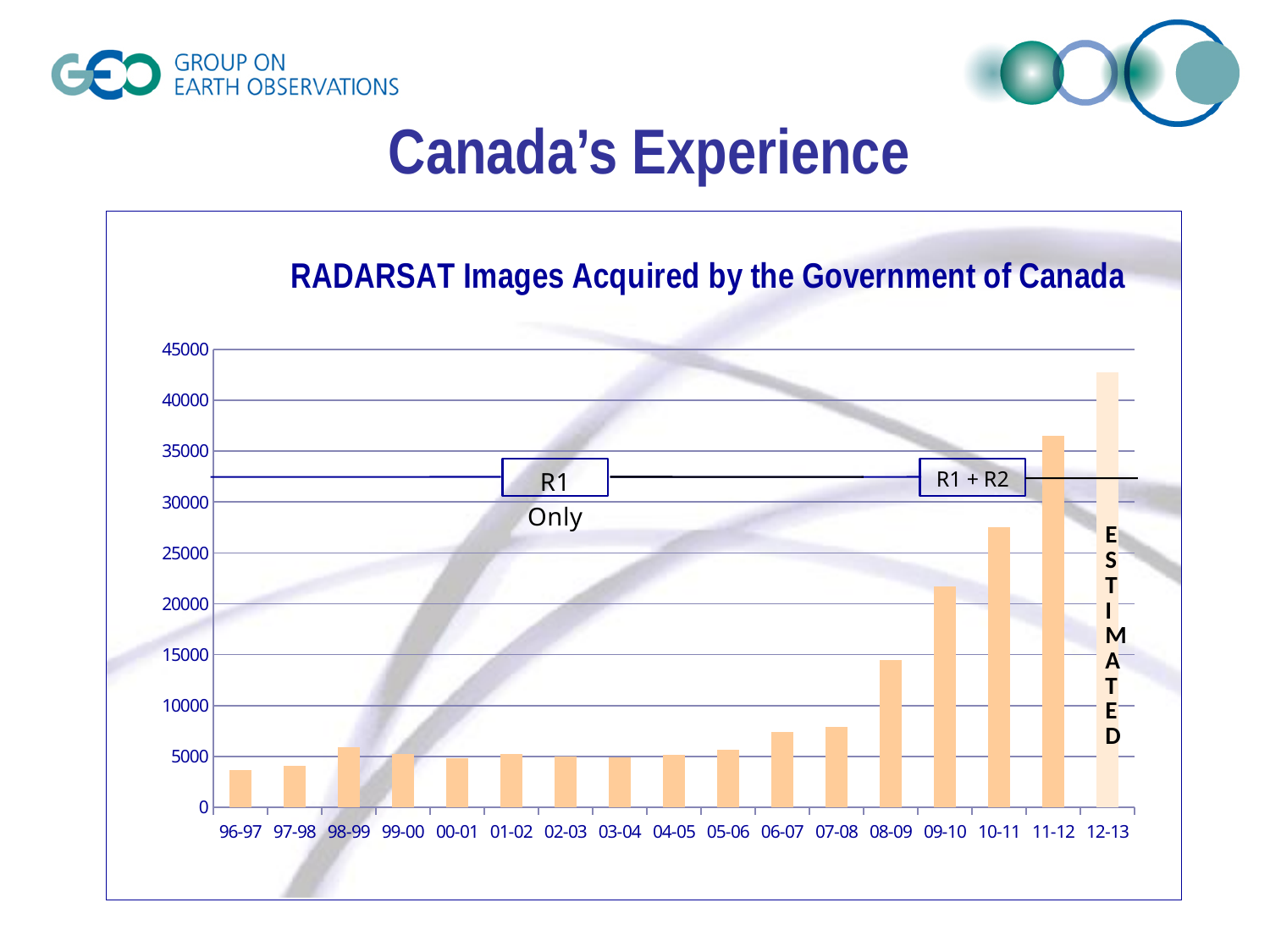
Which year's bar is marked as estimated? 12-13 How many fiscal-year categories are shown on the x axis? 17 Is the value for 12-13 greater or less than 40000? greater What kind of chart is shown on the slide? bar chart Is the value for 08-09 greater or less than 15000? less Do the values generally rise or fall from 07-08 to 12-13? rise Is the value for 11-12 greater or less than 35000? greater Which year has the lowest bar? 96-97 Which year has the highest bar? 12-13 What is the title of the chart? RADARSAT Images Acquired by the Government of Canada Which is larger, the value for 10-11 or the value for 09-10? 10-11